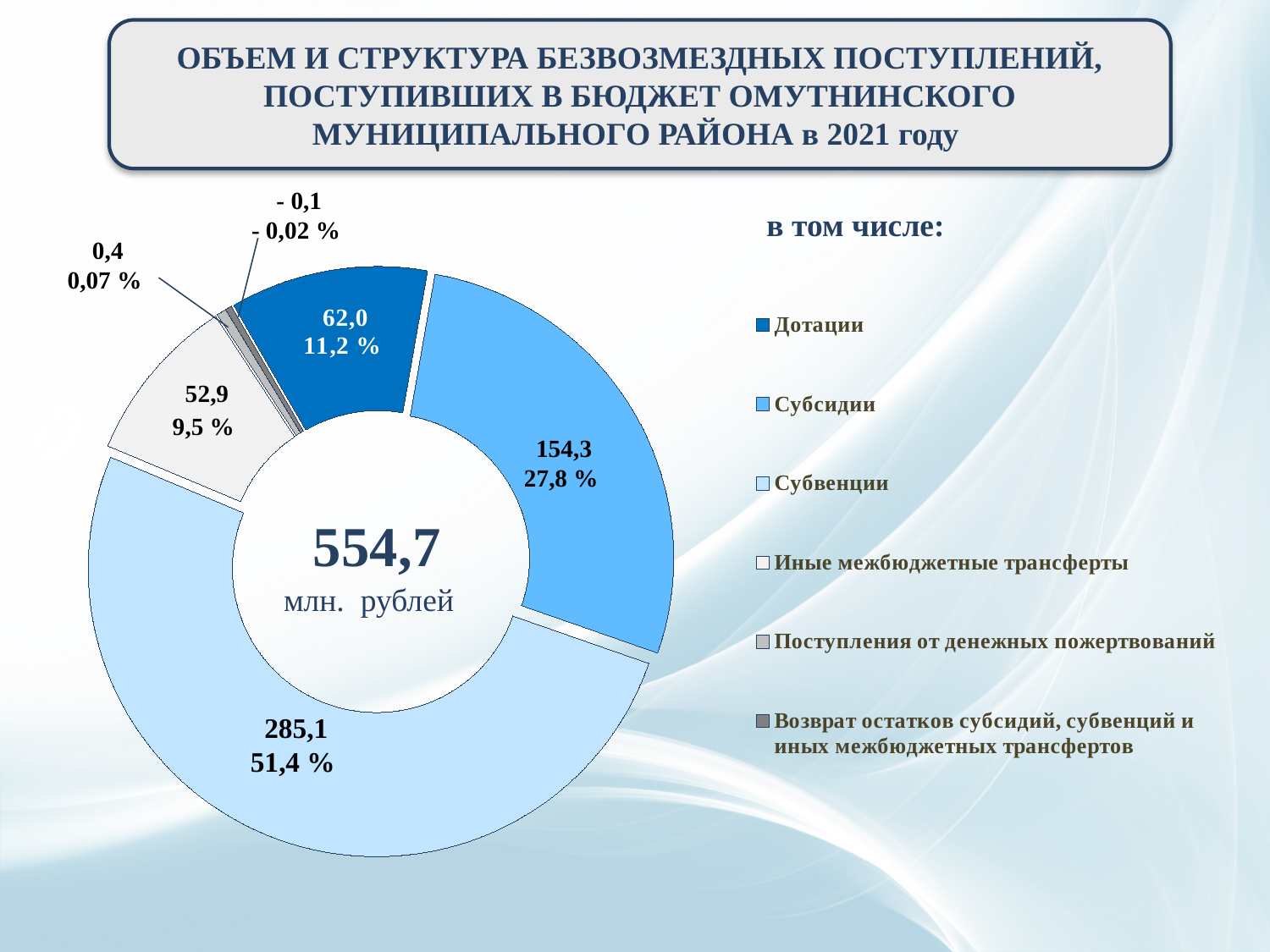
What type of chart is shown on the slide? Doughnut (pie) chart How many categories does the legend list? 6 Which category has the smallest value? Возврат остатков субсидий, субвенций и иных межбюджетных трансфертов What is the value for Субвенции? 285,1 What is the value for Поступления от денежных пожертвований? 0,4 What is the difference between the values for Субвенции and Субсидии? 130,8 What share of the chart does Иные межбюджетные трансферты represent? 9,5 % What is the value for Дотации? 62,0 What share of the chart does Субсидии represent? 27,8 % Which is larger, Дотации or Иные межбюджетные трансферты? Дотации What is the total value shown in the centre of the chart? 554,7 млн. рублей Which category has the largest value? Субвенции